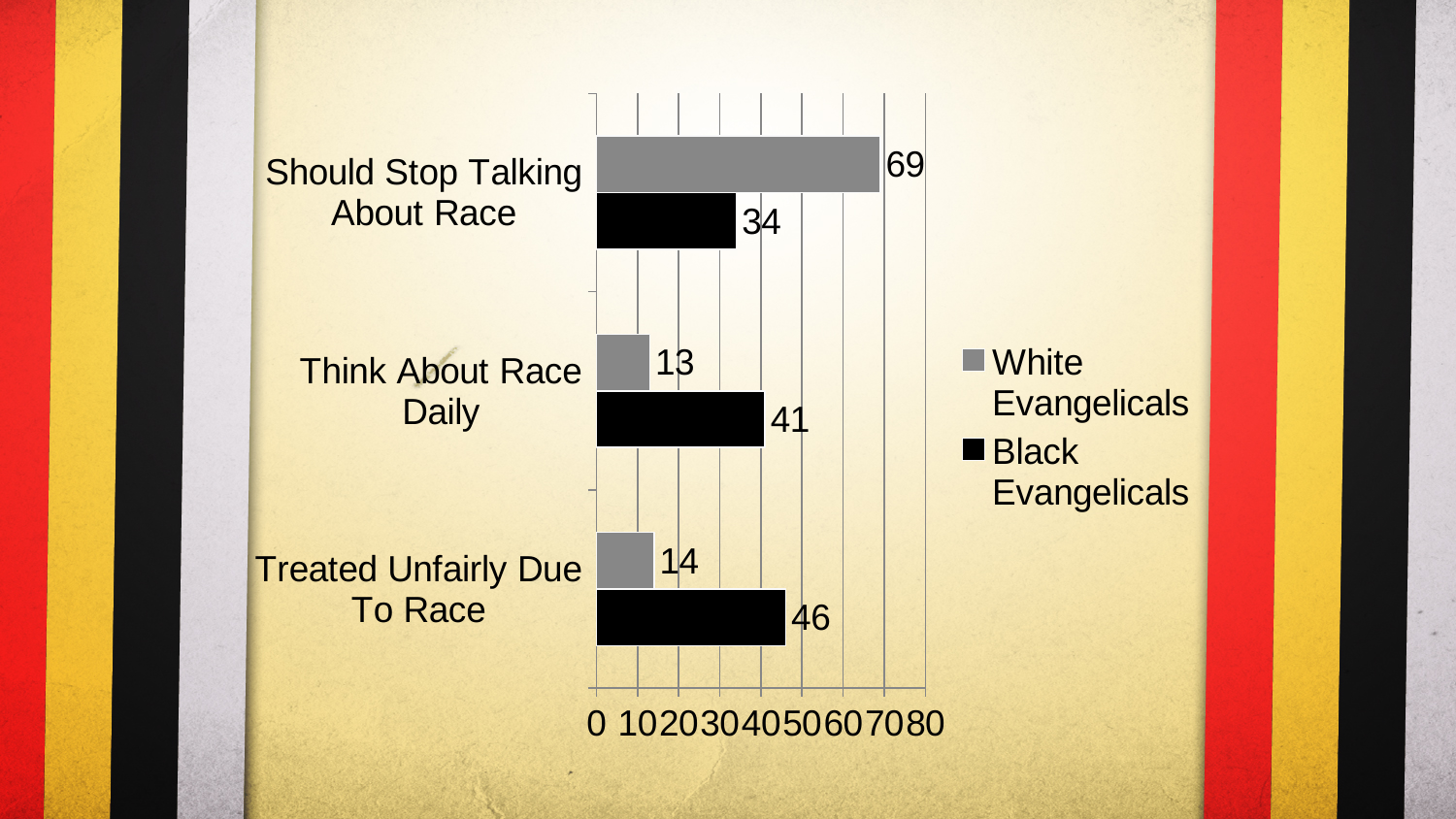
What is the difference between the White Evangelicals and Black Evangelicals values for 'Should Stop Talking About Race'? 35 What is the value for Black Evangelicals in the 'Treated Unfairly Due To Race' category? 46 What colour are the bars for Black Evangelicals? Black What is the value for White Evangelicals in the 'Think About Race Daily' category? 13 How many categories are shown on the chart? 3 Which series has the larger value for 'Treated Unfairly Due To Race', White Evangelicals or Black Evangelicals? Black Evangelicals What is the value for White Evangelicals in the 'Should Stop Talking About Race' category? 69 Which category has the highest value for White Evangelicals? Should Stop Talking About Race What is the value for Black Evangelicals in the 'Think About Race Daily' category? 41 Which category has the lowest value for Black Evangelicals? Should Stop Talking About Race How many series does the legend list? 2 What kind of chart is shown on the slide? Bar chart